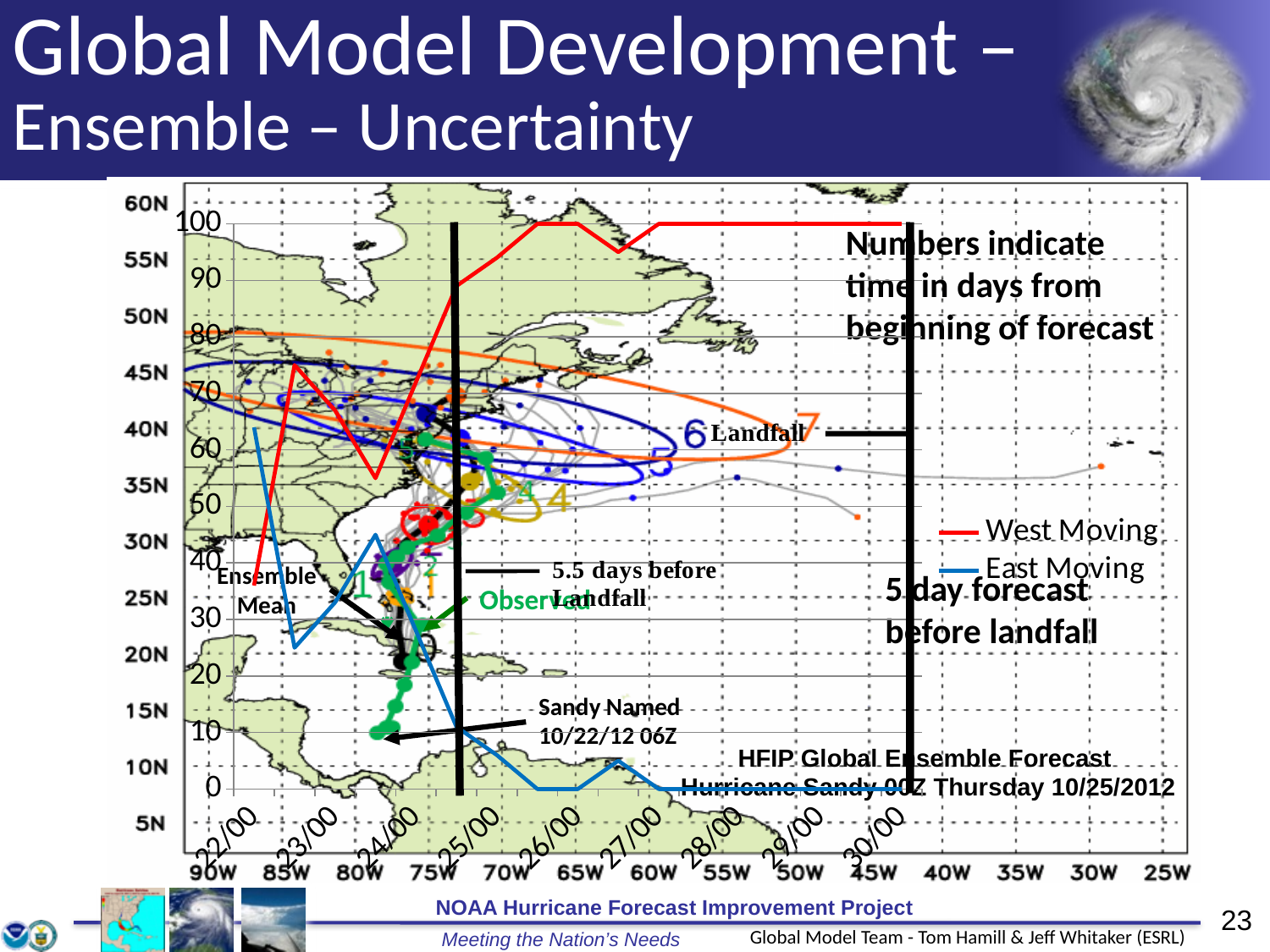
What are the two series named in the chart legend? West Moving and East Moving How many date labels are shown along the chart's x axis? 9 Is the West Moving value at 28/00 greater or less than 90? greater Does the East Moving line rise or fall between 24/00 and 26/00? fall Does the West Moving line rise or fall between 23/00 and 25/00? rise How many series does the chart legend list? 2 Which series reaches the highest value on the chart? West Moving At 25/00, which series has the higher value, West Moving or East Moving? West Moving What kind of chart is overlaid on the map on this slide? line chart What colour is the West Moving line in the chart? red What is the East Moving value at 26/00? 0